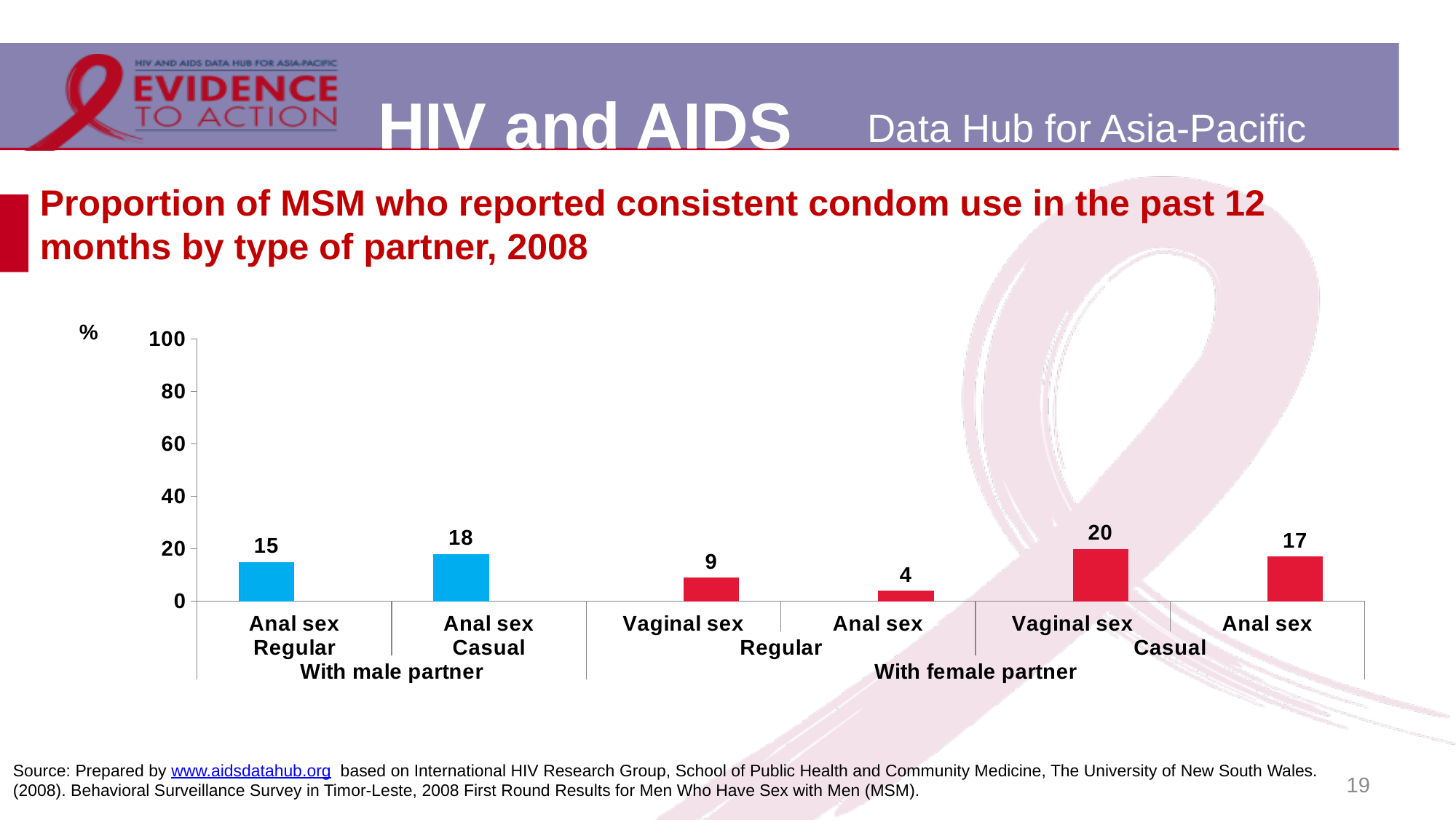
What is the value for anal sex with a casual male partner? 18 What is the value for vaginal sex with a regular female partner? 9 Which bar has the highest value? Vaginal sex, Casual, With female partner What type of chart is shown on the slide? Bar chart What is the maximum value shown on the vertical axis? 100 Which is larger: the value for vaginal sex with a casual female partner or anal sex with a casual female partner? Vaginal sex with a casual female partner What is the value for anal sex with a regular female partner? 4 What is the value for vaginal sex with a casual female partner? 20 What is the value for anal sex with a regular male partner? 15 What is the difference between the values for anal sex with a casual male partner and anal sex with a regular male partner? 3 How many bars are plotted in the chart? 6 Which bar has the lowest value? Anal sex, Regular, With female partner